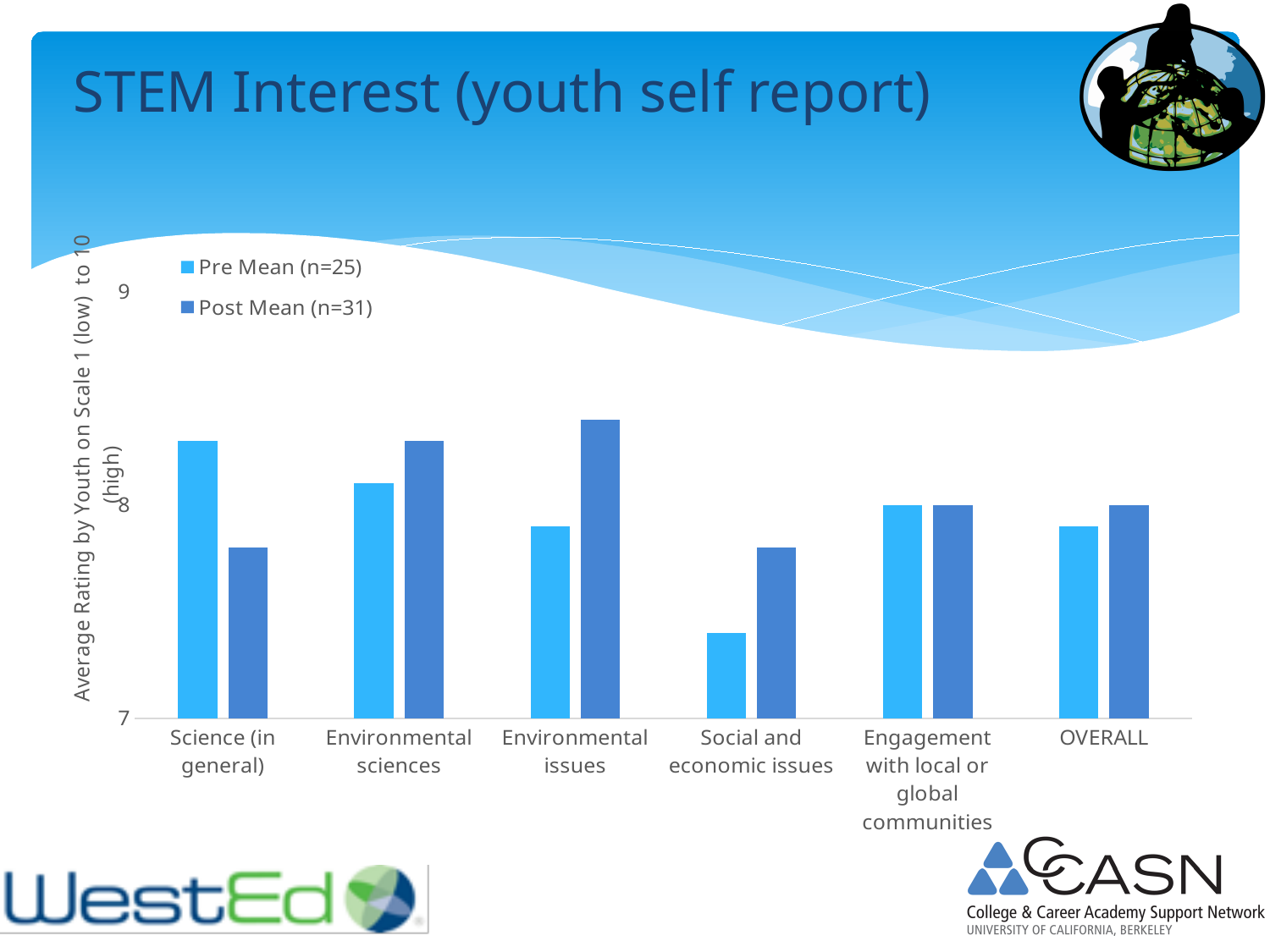
For Science (in general), which is larger: the Pre Mean or the Post Mean? Pre Mean Which category has the lowest Pre Mean (n=25) bar? Social and economic issues Is the Pre Mean value for Science (in general) greater or less than 8? greater What is the title of the chart on the slide? STEM Interest (youth self report) For Social and economic issues, which is larger: the Pre Mean or the Post Mean? Post Mean Is the Post Mean value for Science (in general) greater or less than 8? less How many categories are shown along the x axis? 6 For Environmental issues, which is larger: the Pre Mean or the Post Mean? Post Mean What kind of chart is shown on the slide? bar chart Is the Pre Mean value for Social and economic issues greater or less than 8? less Which category has the highest Post Mean (n=31) bar? Environmental issues How many series does the legend list? 2